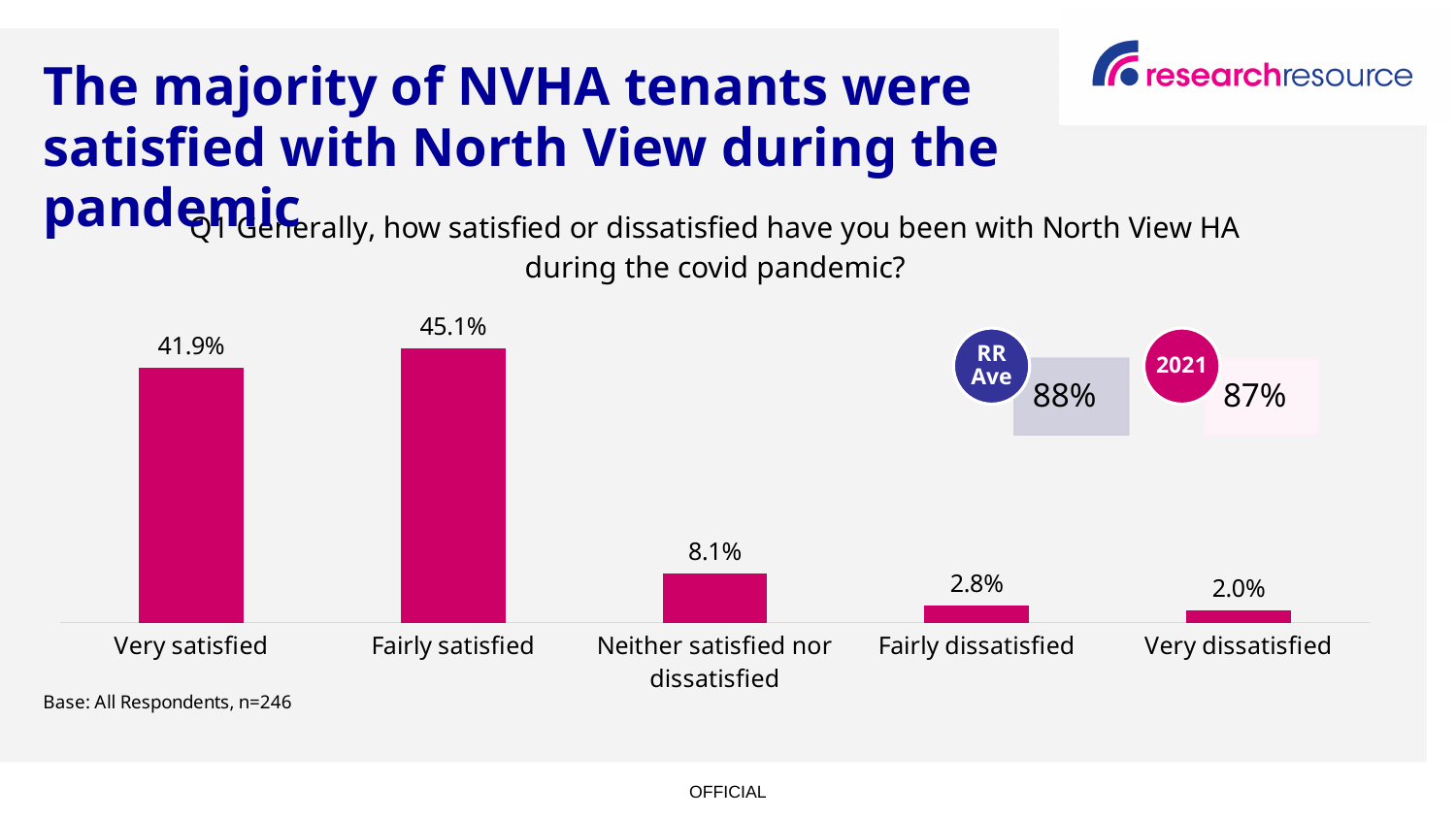
What is the difference between Fairly satisfied and Very satisfied? 3.2% What is the RR Ave value shown on the slide? 88% Which category has the highest value? Fairly satisfied What is the value for Very satisfied? 41.9% What is the value for Neither satisfied nor dissatisfied? 8.1% What is the base size stated below the chart? n=246 What is the value for Fairly satisfied? 45.1% How many categories are shown on the chart? 5 What is the value for Very dissatisfied? 2.0% What kind of chart is shown on the slide? Bar chart Which category has the lowest value? Very dissatisfied Which is larger, Neither satisfied nor dissatisfied or Fairly dissatisfied? Neither satisfied nor dissatisfied